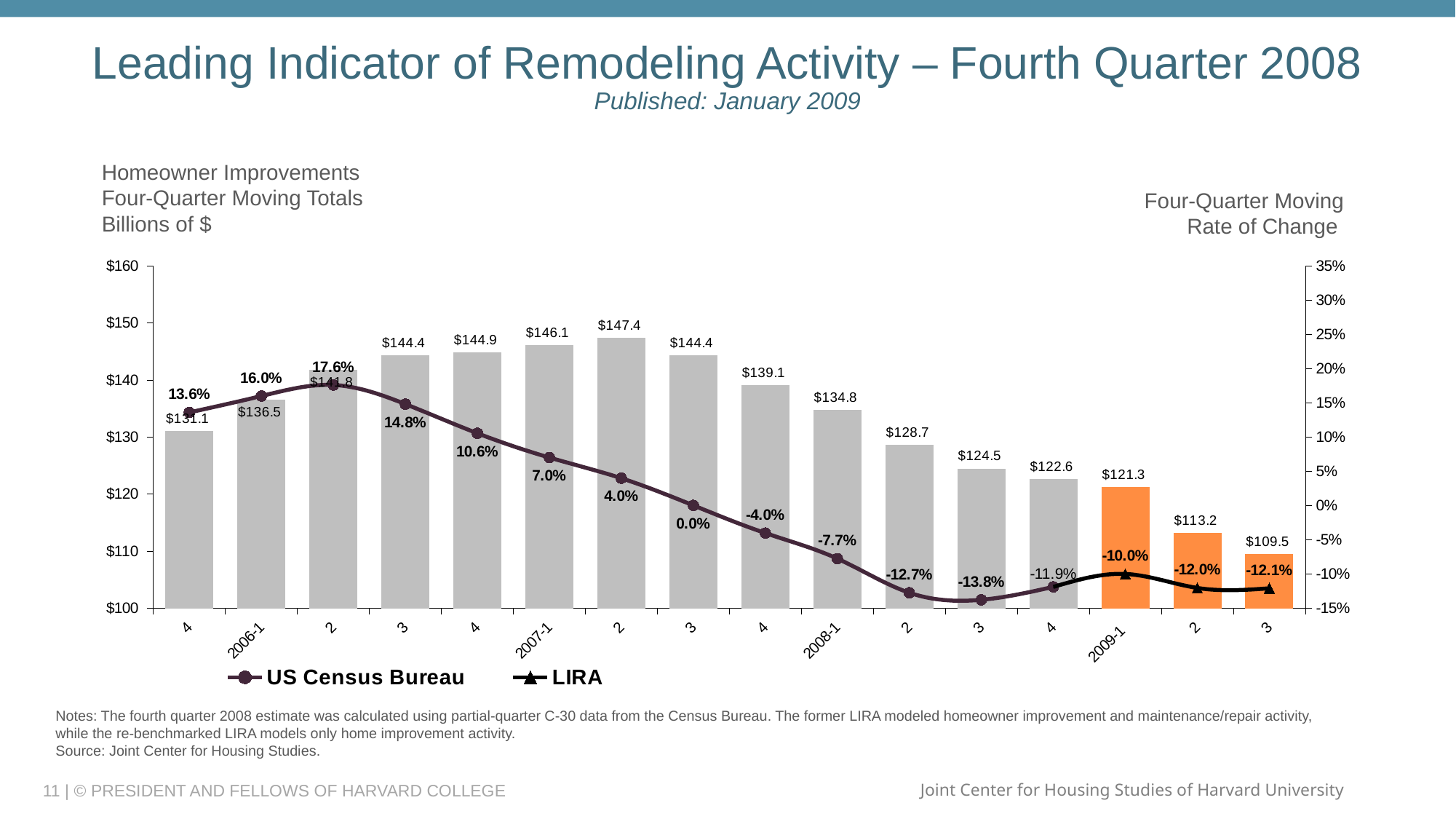
What is the difference between the bar values for 2007-1 and 2008-1? $11.3 Which is larger, the bar value for 2006-1 or the bar value for 2009-1? 2006-1 What rate of change is labeled on the line at 2006-1? 16.0% What is the highest rate of change labeled on the line? 17.6% What is the value of the bar for 2008-1? $134.8 Which quarter has the lowest bar value? 2009 quarter 3 ($109.5) Is the bar value for 2008-1 greater or less than $130? greater How many bars are plotted in the chart? 16 Which quarter has the highest bar value? 2007 quarter 2 ($147.4) What rate of change is labeled on the line at 2008-1? -7.7% How many series does the legend list? 2 What is the value of the bar for 2009-1? $121.3